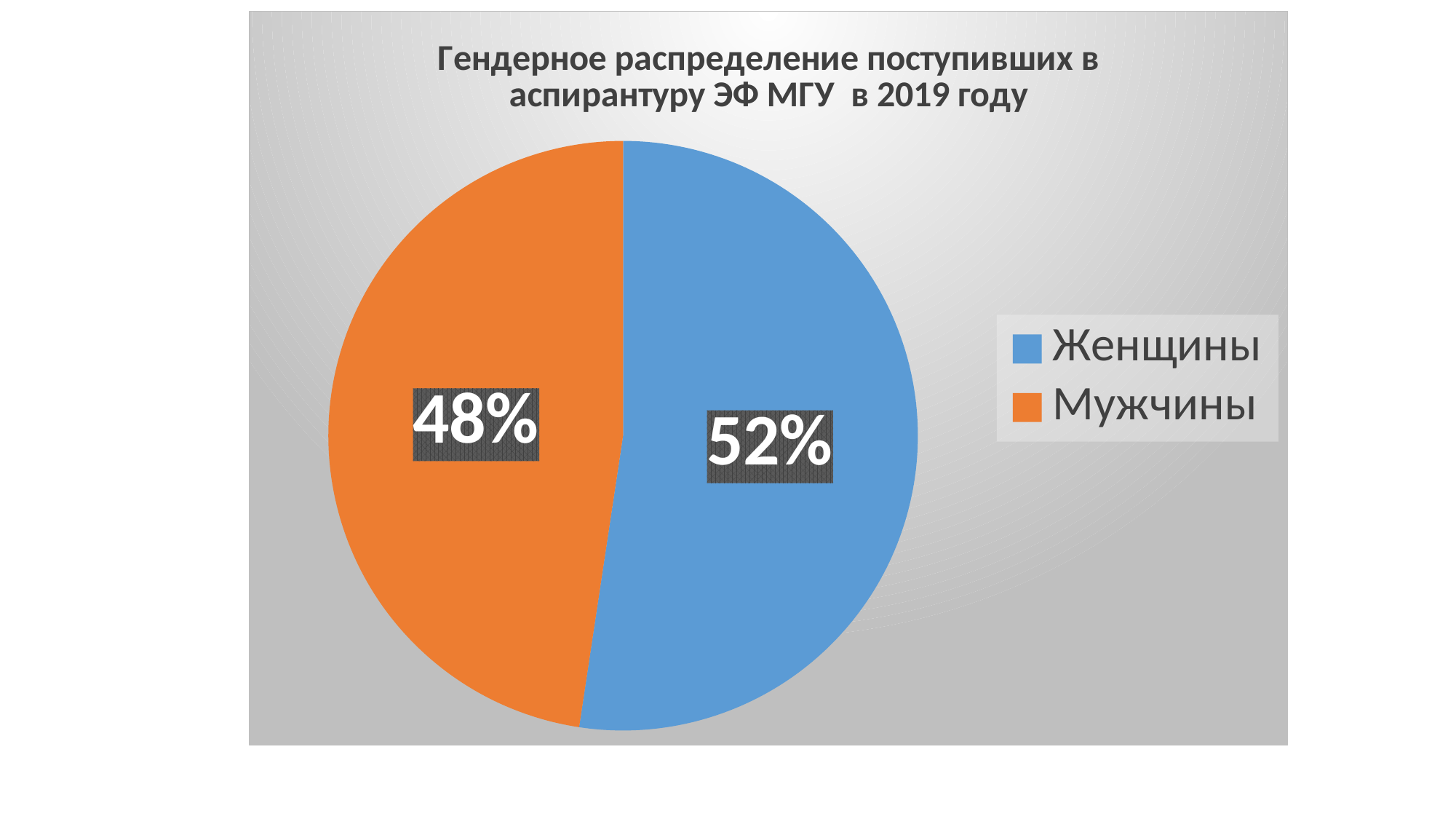
What is the difference in percentage points between the Женщины and Мужчины shares? 4 What share of the pie is Женщины? 52% How many entries does the legend list? 2 What colour is the Мужчины slice? Orange Which is larger, the share for Женщины or the share for Мужчины? Женщины Which category has the largest share of the pie? Женщины Which category has the smallest share of the pie? Мужчины How many slices does the pie chart have? 2 What share of the pie is Мужчины? 48% What kind of chart is shown on the slide? Pie chart What is the title of the chart? Гендерное распределение поступивших в аспирантуру ЭФ МГУ в 2019 году